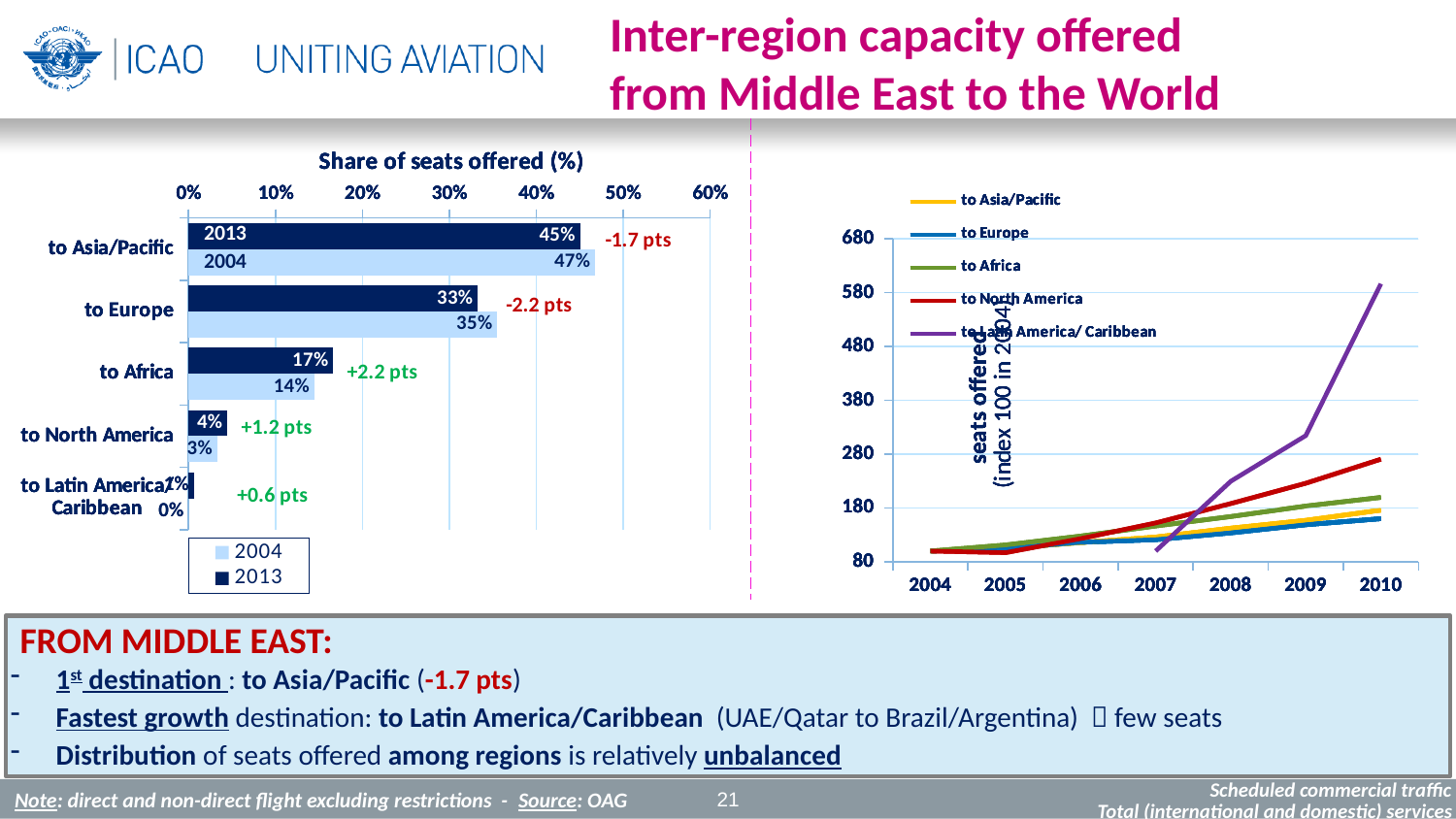
How many series does the legend of the line chart on the right list? 5 In the 'Share of seats offered (%)' bar chart, what is the 2013 share for 'to Asia/Pacific'? 45% In the 'Share of seats offered (%)' bar chart, what is the difference between the 2013 and 2004 shares for 'to Africa'? +2.2 pts How many series does the legend of the 'Share of seats offered (%)' chart list? 2 What kind of chart is the chart on the right side of the slide? line chart In the 'Share of seats offered (%)' bar chart, which destination has the lowest 2004 share? to Latin America/Caribbean In the 'Share of seats offered (%)' bar chart, what is the 2013 share for 'to Africa'? 17% In the 'Share of seats offered (%)' bar chart, is the 2013 share for 'to Europe' larger or smaller than its 2004 share? smaller How many destination categories does the 'Share of seats offered (%)' bar chart show? 5 In the 'Share of seats offered (%)' bar chart, what is the 2004 share for 'to Europe'? 35% In the 'Share of seats offered (%)' bar chart, which destination has the highest 2013 share? to Asia/Pacific In the line chart on the right, is the 2010 value for 'to Latin America/Caribbean' greater or less than 480? greater